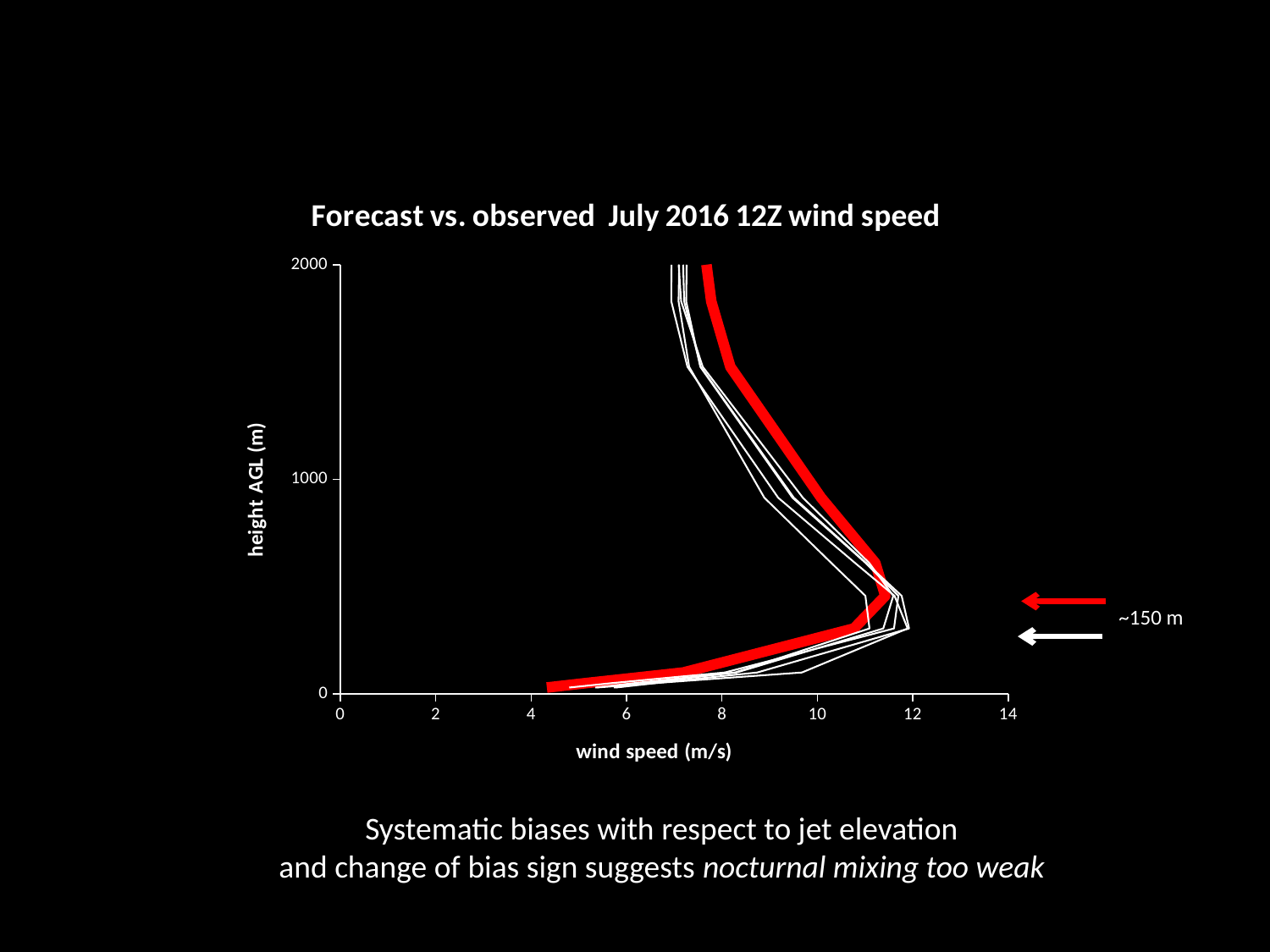
What is the label of the x axis? wind speed (m/s) At a height of 2000 m, which has the higher wind speed: the thick red line or the thin white lines? the thick red line What kind of chart is shown on the slide? line chart What is the highest tick value shown on the y axis (height AGL)? 2000 What is the title of the chart? Forecast vs. observed July 2016 12Z wind speed Does the wind speed of the thick red line increase or decrease as height rises from the surface to about 500 m? increase Is the maximum wind speed reached by the thick red line greater or less than 10 m/s? greater Is the wind speed of the thick red line at its lowest plotted height (near 0 m) greater or less than 6 m/s? less Is the wind speed of the thick red line at a height of 2000 m greater or less than 6 m/s? greater What is the highest tick value shown on the x axis (wind speed)? 14 Which reaches a higher maximum wind speed: the thick red line or the thin white lines? the thin white lines